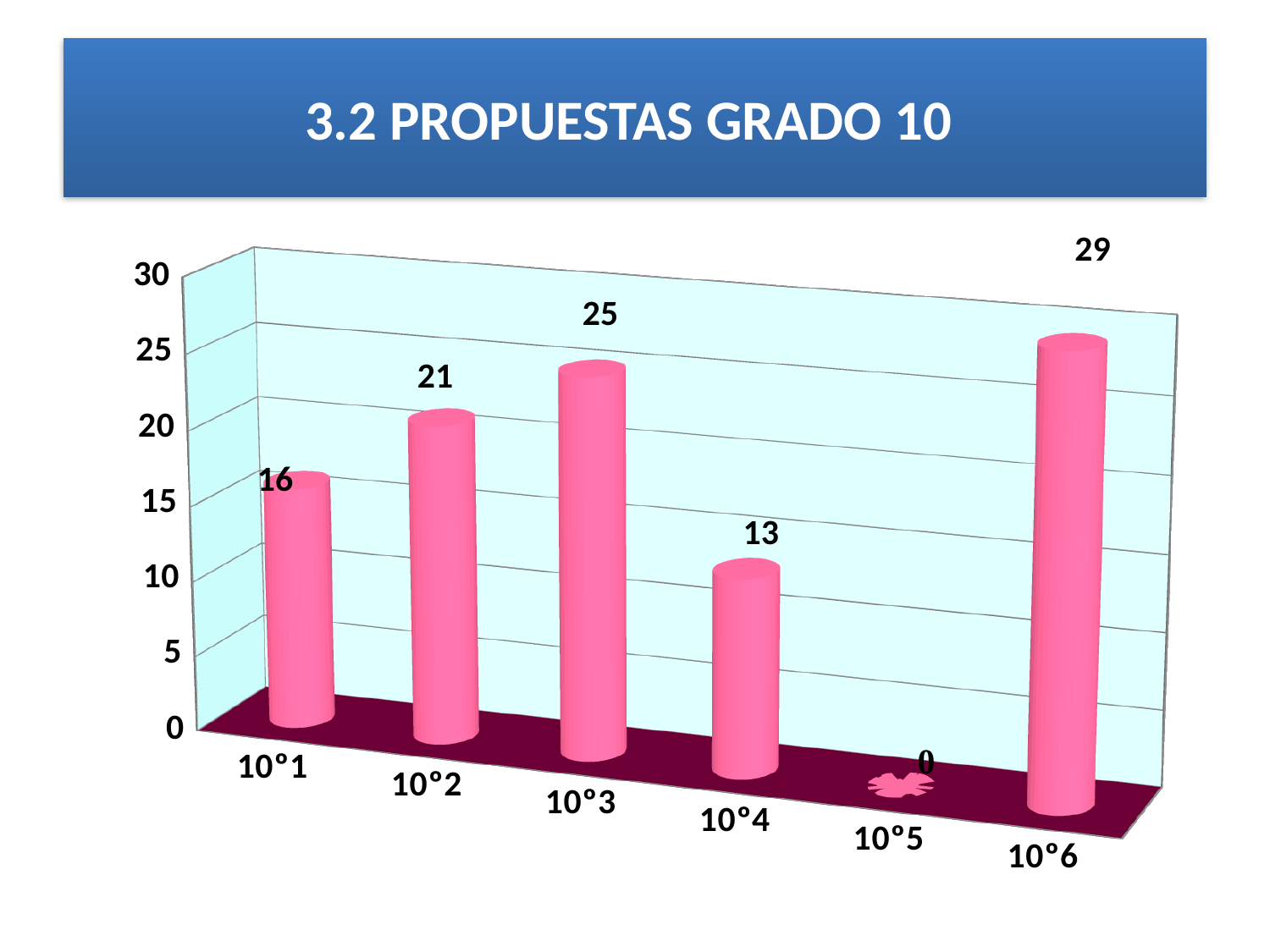
What is the value for 10°1? 16 What kind of chart is shown on the slide? bar chart Which is larger, the value for 10°2 or the value for 10°4? 10°2 What is the title of the slide? 3.2 PROPUESTAS GRADO 10 Which category has the lowest value? 10°5 How many categories are shown on the x axis? 6 What is the difference between the values for 10°2 and 10°1? 5 What is the difference between the values for 10°6 and 10°4? 16 What is the value for 10°3? 25 What is the value for 10°5? 0 Is the value for 10°3 greater or less than 20? greater Which category has the highest value? 10°6